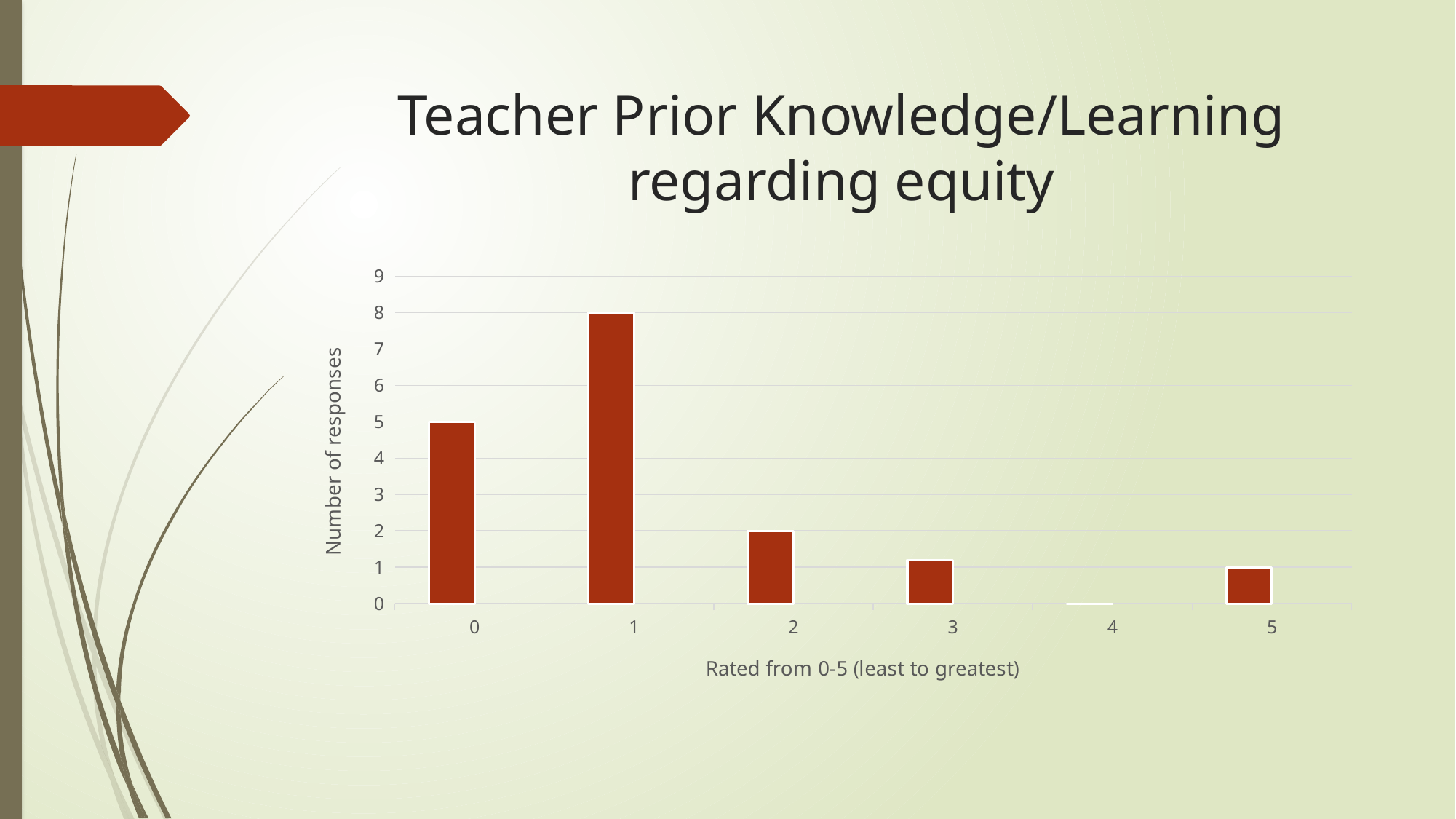
How many rating categories are shown on the x axis? 6 Which rating received the fewest responses? 4 What is the difference between the number of responses for rating 1 and rating 0? 3 Which rating has more responses, 0 or 2? 0 What kind of chart is shown on the slide? Bar chart How many responses gave a rating of 1? 8 Is the number of responses for rating 3 greater or less than 2? less What is the label of the y axis? Number of responses How many responses gave a rating of 2? 2 How many responses gave a rating of 4? 0 Which rating received the most responses? 1 How many responses gave a rating of 0? 5